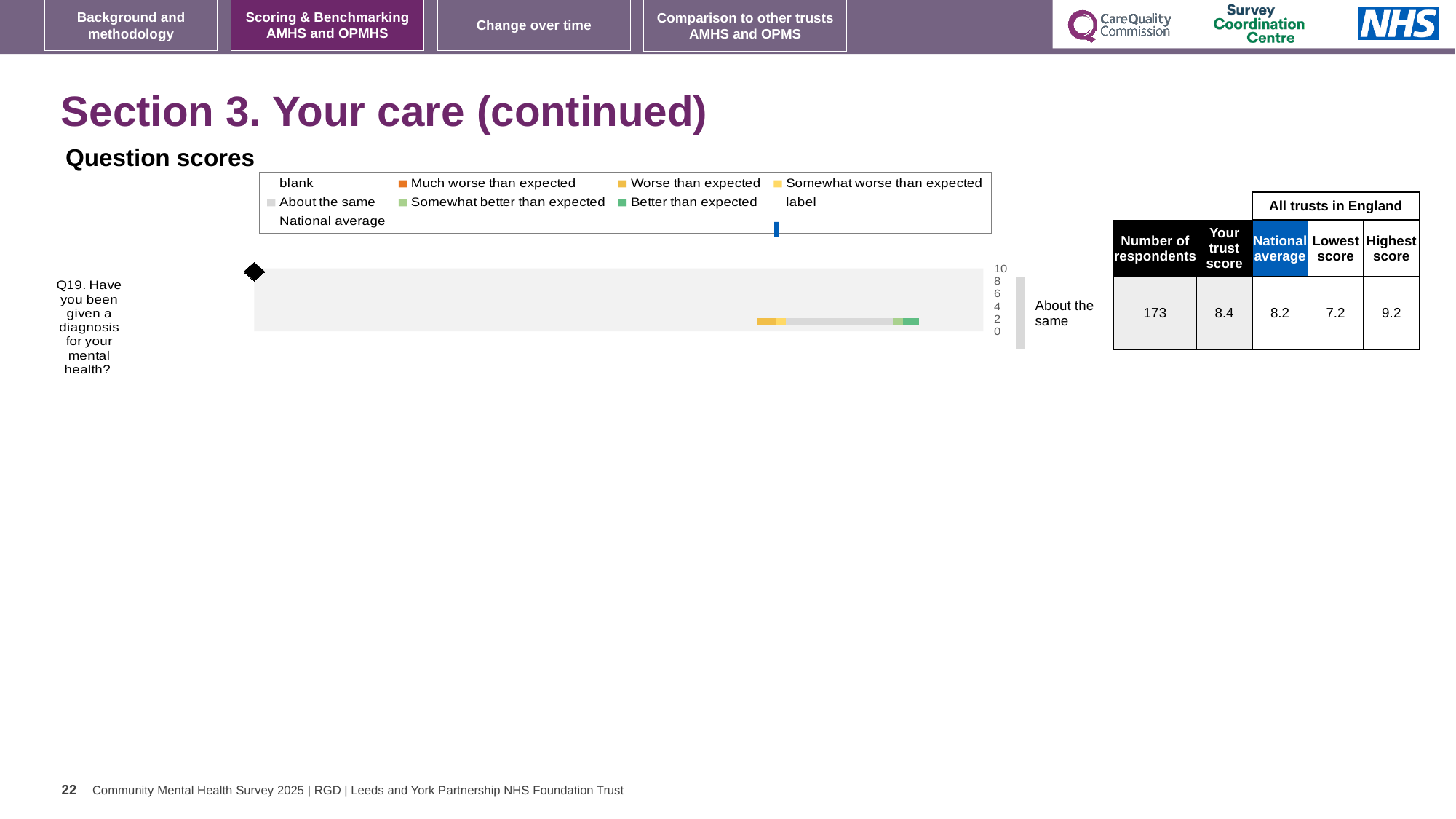
How many questions are plotted on the chart? 1 Which is larger for Q19, the trust score or the national average? the trust score What is the lowest score among all trusts in England for Q19? 7.2 Which benchmark category is Q19 placed in? About the same What is the highest score among all trusts in England for Q19? 9.2 What is the highest value shown on the chart's score axis? 10 What kind of chart is used to show the Q19 question score? bar chart What is the national average score for Q19? 8.2 How many respondents answered Q19? 173 What is the trust score for Q19 (Have you been given a diagnosis for your mental health?)? 8.4 What is the difference between the highest and lowest scores for Q19? 2.0 What is the difference between the trust score and the national average for Q19? 0.2